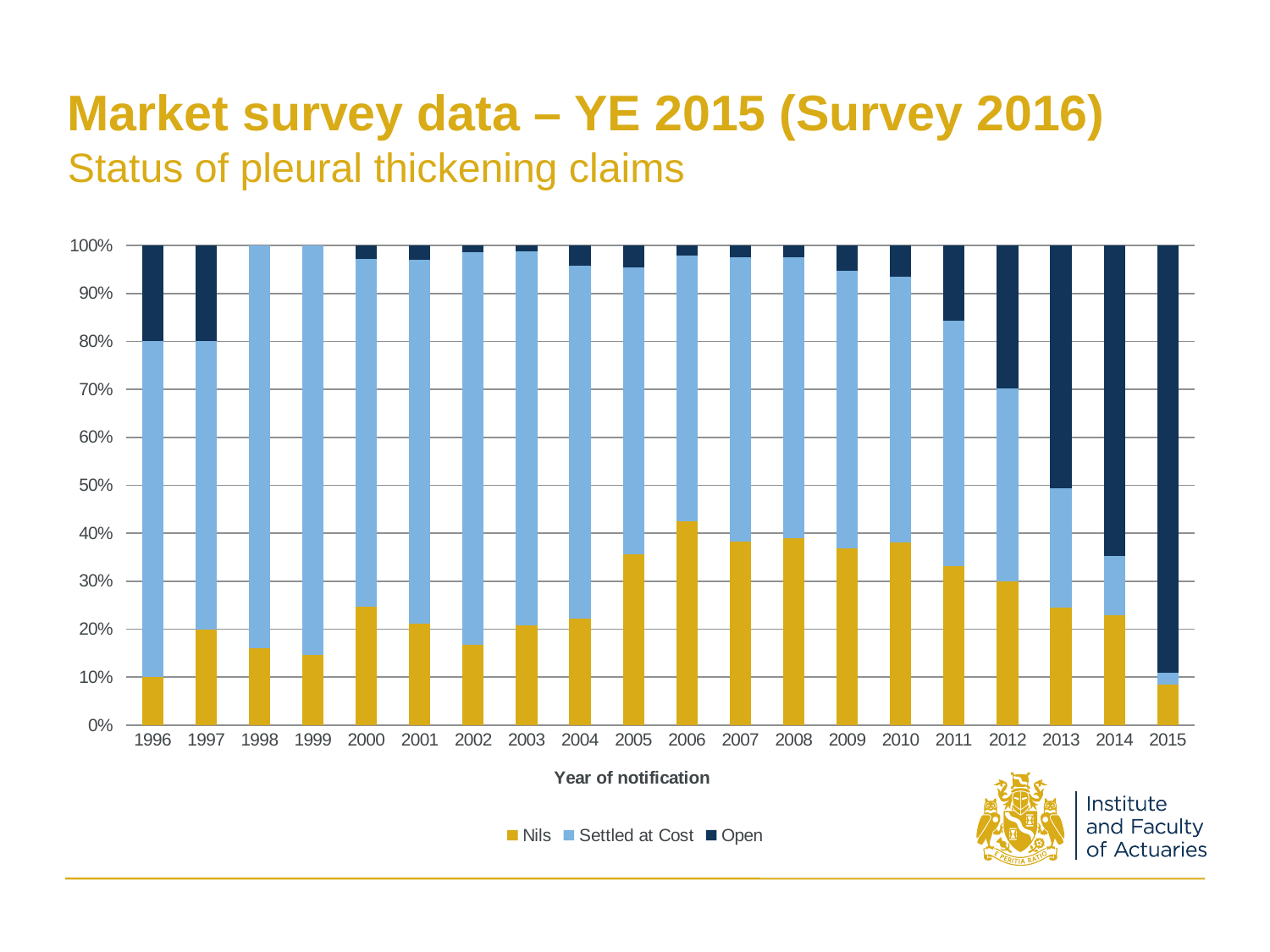
Does the Open share rise or fall from 2010 to 2015? Rise Which year has the larger Nils share, 1996 or 1997? 1997 Is the Nils share for 2005 greater or less than 30%? greater What is the title of the x axis? Year of notification How many years of notification are shown on the x axis? 20 In which year of notification is the Nils share the highest? 2006 What kind of chart is shown on the slide? Stacked bar chart Is the Nils share for 2015 greater or less than 10%? less Which series is shown in dark blue in the legend? Open Is the Open share for 2015 greater or less than 80%? greater How many series does the legend list? 3 In which year of notification is the Open share the highest? 2015